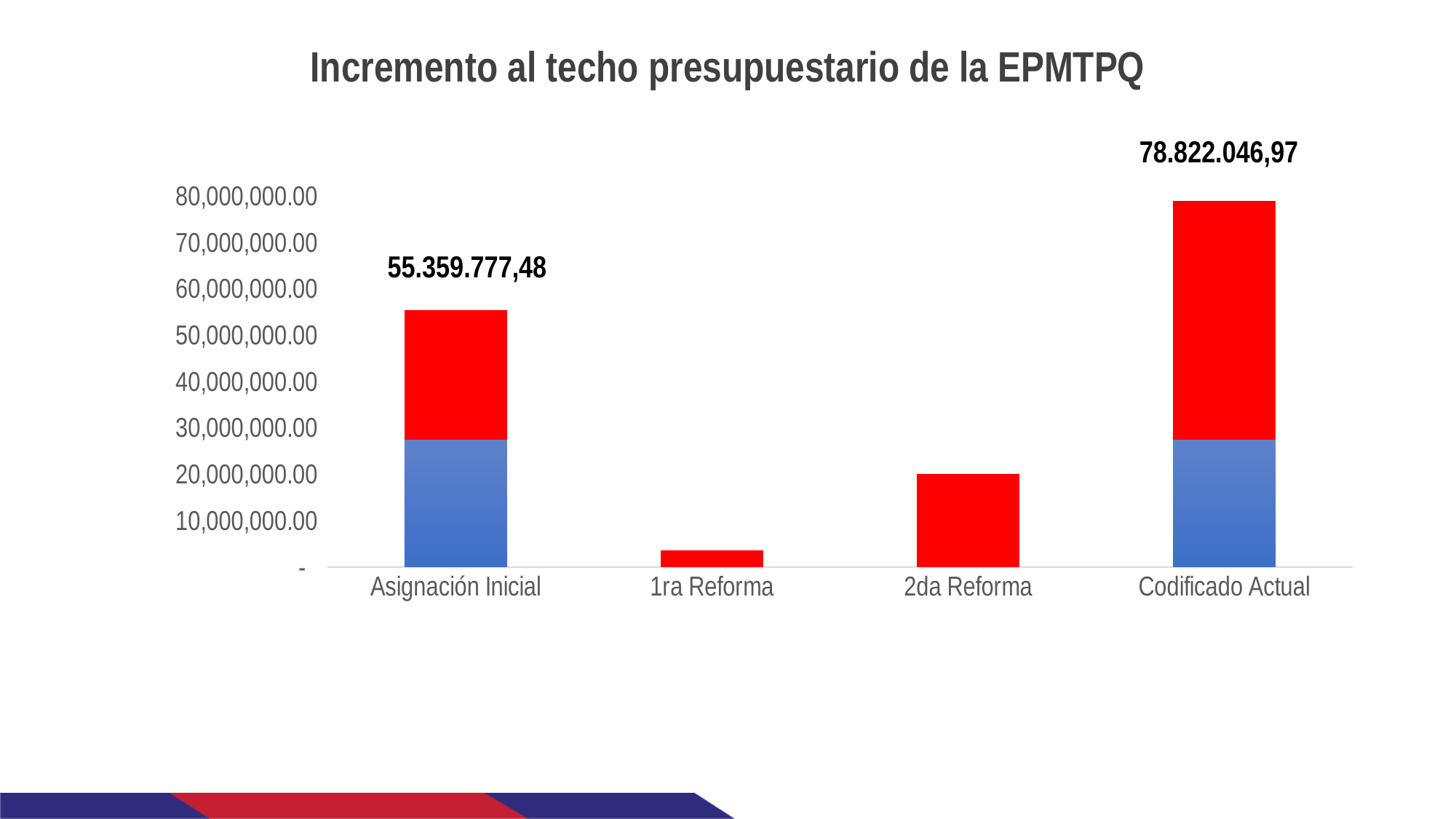
Which category has the highest bar? Codificado Actual Is the value for 2da Reforma greater or less than 10,000,000.00? greater Is the value for 1ra Reforma greater or less than 10,000,000.00? less What is the value labelled for Asignación Inicial? 55.359.777,48 Which category has the lowest bar? 1ra Reforma How many categories are shown on the x axis? 4 What is the value labelled for Codificado Actual? 78.822.046,97 What is the difference between the labelled values for Codificado Actual and Asignación Inicial? 23.462.269,49 What is the title of the chart? Incremento al techo presupuestario de la EPMTPQ What kind of chart is shown on the slide? bar chart Is the value for 2da Reforma greater or less than 30,000,000.00? less Which is larger, the bar for Asignación Inicial or the bar for 2da Reforma? Asignación Inicial